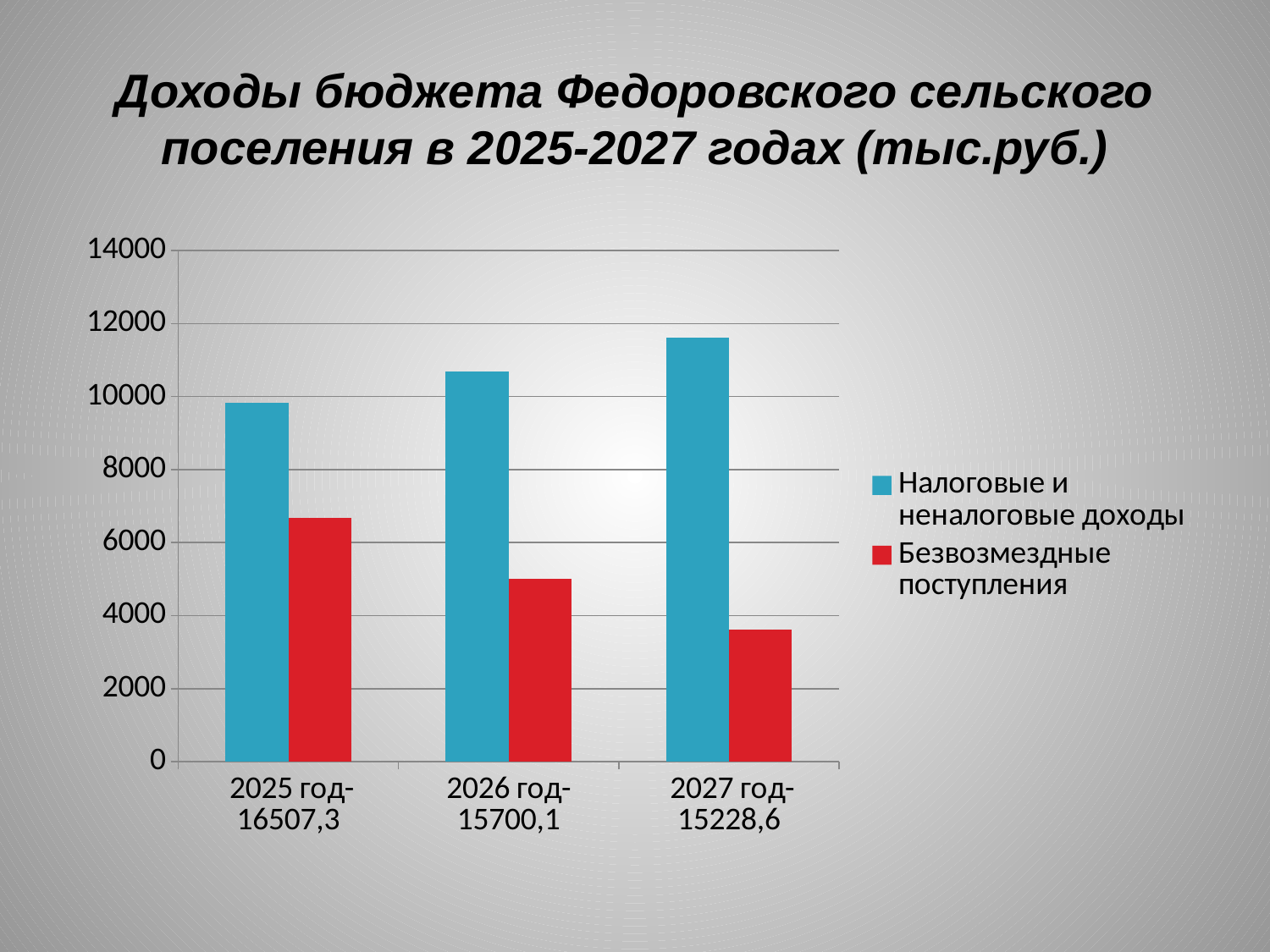
What total figure is printed in the x-axis label for 2025 год? 16507,3 Which year has the highest value for Налоговые и неналоговые доходы? 2027 год What kind of chart is shown on the slide? bar chart Is the value for Безвозмездные поступления in 2027 greater or less than 4000? less Is the value for Безвозмездные поступления in 2025 greater or less than 6000? greater Which year has the lowest value for Безвозмездные поступления? 2027 год In 2027, which is larger: Налоговые и неналоговые доходы or Безвозмездные поступления? Налоговые и неналоговые доходы Do the values for Безвозмездные поступления rise or fall from 2025 to 2027? fall Do the values for Налоговые и неналоговые доходы rise or fall from 2025 to 2027? rise How many year categories are shown on the x axis? 3 How many series does the legend list? 2 Is the value for Налоговые и неналоговые доходы in 2026 greater or less than 10000? greater